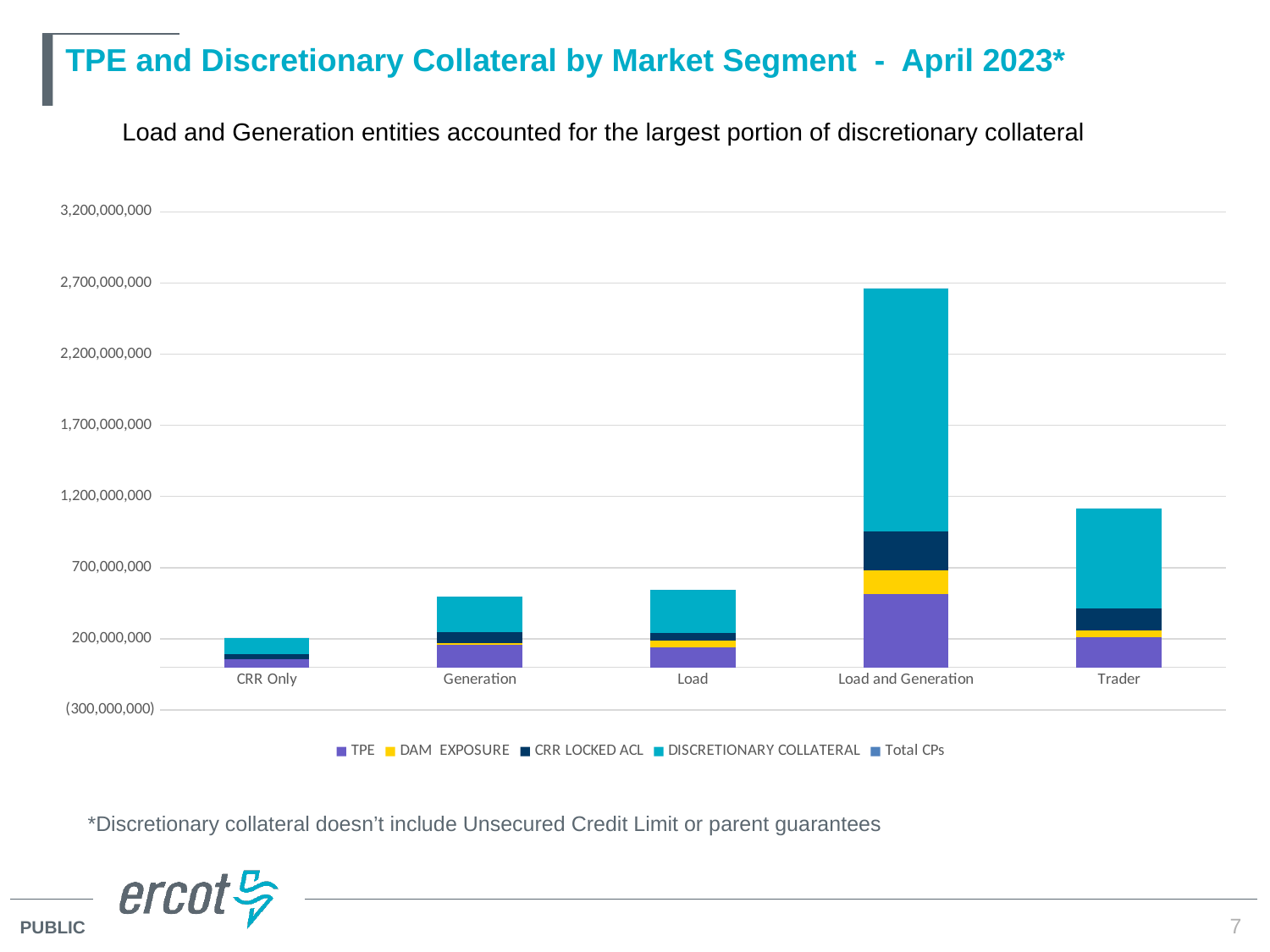
Which series in the legend is shown in yellow? DAM EXPOSURE What kind of chart is shown on the slide? Stacked bar chart Which has the larger total stacked bar, Trader or Load? Trader What is the title of the chart on the slide? TPE and Discretionary Collateral by Market Segment - April 2023* Is the total stacked bar for Generation greater or less than 700,000,000? less How many series does the legend list? 5 Is the total stacked bar for Trader greater or less than 1,200,000,000? less Which market segment has the shortest stacked bar? CRR Only Is the total stacked bar for Load and Generation greater or less than 2,200,000,000? greater How many market segment categories are shown on the x axis? 5 Which market segment has the tallest stacked bar? Load and Generation